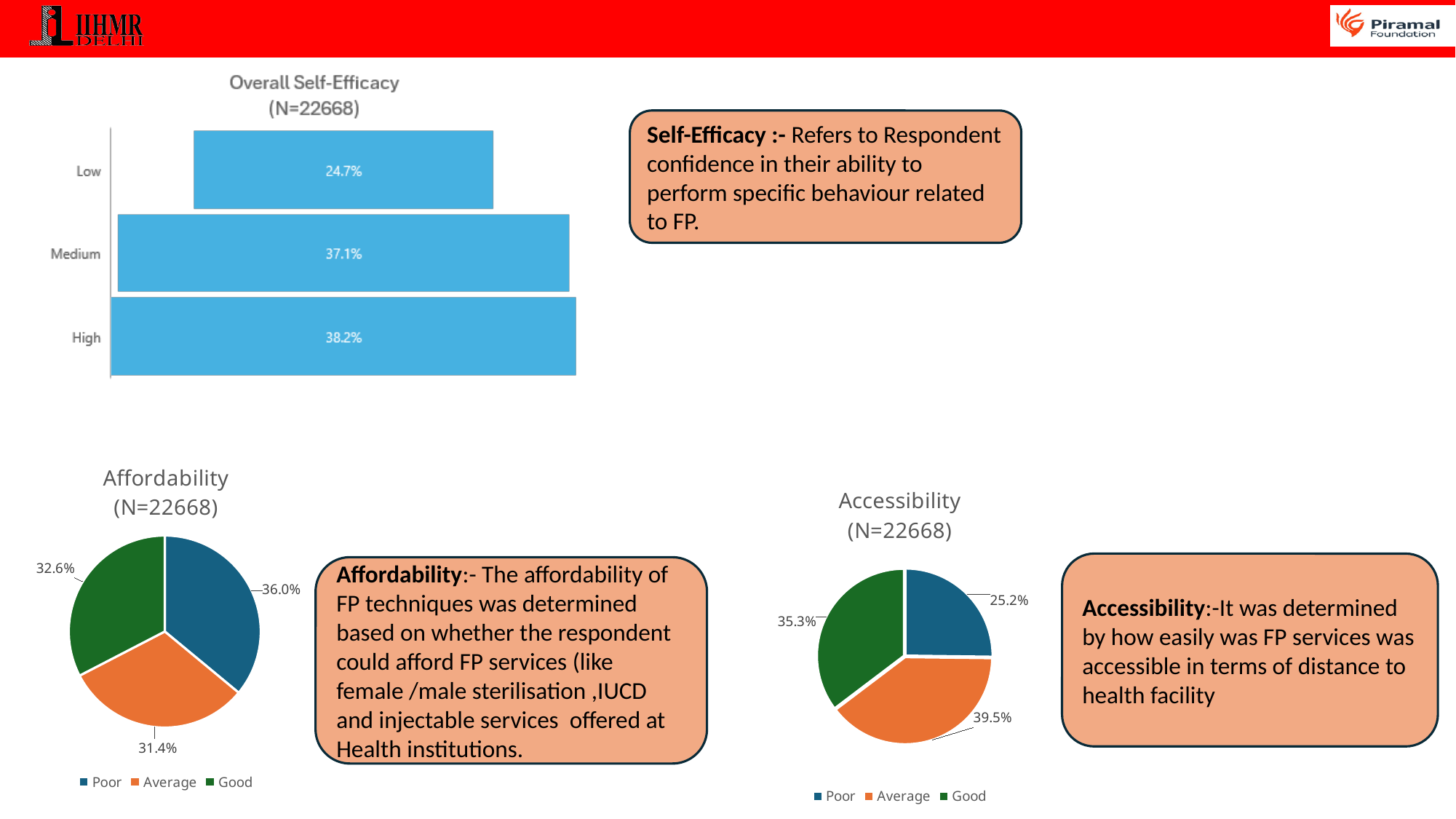
In the Accessibility pie chart, is the Poor share larger or smaller than the Good share? Smaller In the Overall Self-Efficacy chart, which category has the highest percentage? High How many categories are shown in the Overall Self-Efficacy chart? 3 In the Overall Self-Efficacy chart, what percentage of respondents have Medium self-efficacy? 37.1% In the Overall Self-Efficacy chart, what is the difference between the High and Low percentages? 13.5% In the Accessibility pie chart, what share is labelled Average? 39.5% What kind of chart is the Overall Self-Efficacy chart? Bar chart In the Affordability pie chart, which category has the smallest share? Average In the Overall Self-Efficacy chart, what percentage of respondents have Low self-efficacy? 24.7% In the Affordability pie chart, what share is labelled Poor? 36.0% How many entries does the legend of the Accessibility pie chart list? 3 In the Accessibility pie chart, which category has the largest share? Average